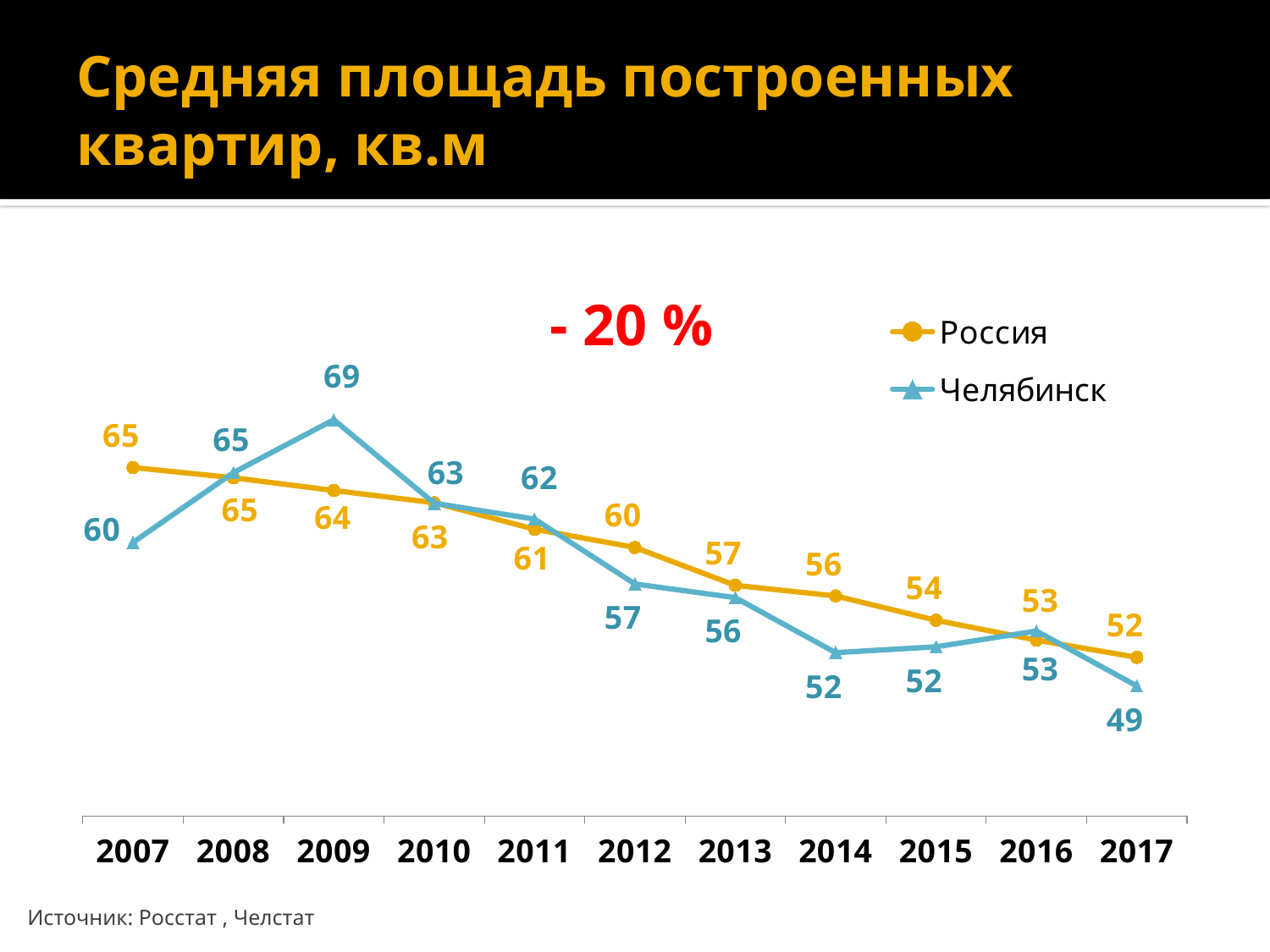
In 2014, which series has the larger value, Россия or Челябинск? Россия How many series does the legend list? 2 Does the Россия series rise or fall from 2007 to 2017? Fall In which year is the Челябинск series at its highest? 2009 What kind of chart is shown on the slide? Line chart By how much did the Россия value fall from 2007 to 2017? 13 How many years are shown on the x axis? 11 What is the value for Челябинск in 2007? 60 What is the value for Россия in 2017? 52 In which year is the Челябинск series at its lowest? 2017 In 2009, how much higher is the Челябинск value than the Россия value? 5 What is the value for Челябинск in 2009? 69